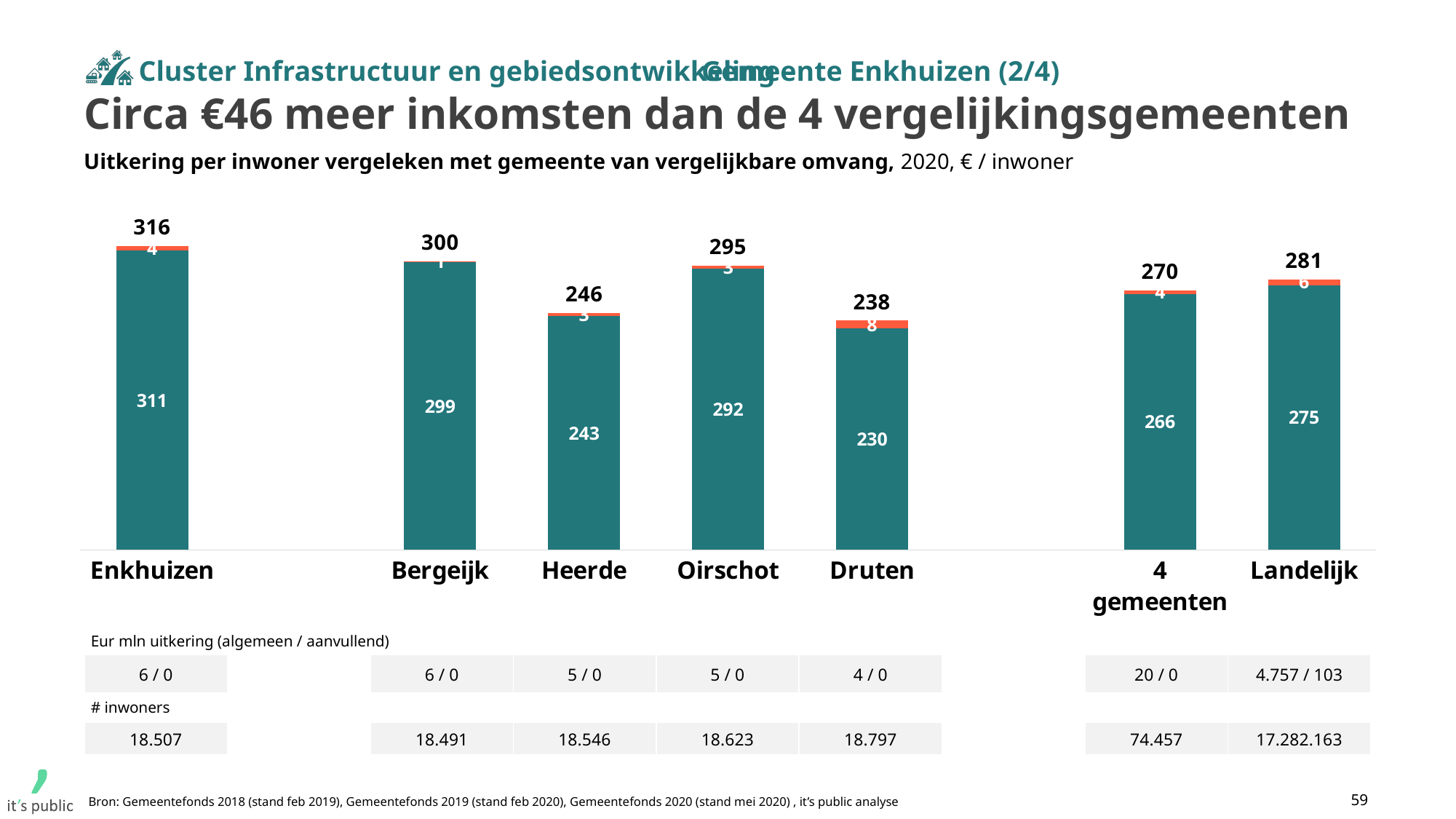
What is the total value shown above the bar for Landelijk? 281 How many categories (bars) are shown in the chart? 7 What is the total value shown above the bar for Enkhuizen? 316 What is the value of the teal segment for 4 gemeenten? 266 Which category has the lowest total value? Druten Which has a higher total value, Bergeijk or Oirschot? Bergeijk What kind of chart is shown on the slide? Stacked bar chart What is the value of the small orange segment on top of the Druten bar? 8 Which category has the highest total value? Enkhuizen What is the difference between the total for Heerde and the total for Druten? 8 What is the difference between the total for Enkhuizen and the total for 4 gemeenten? 46 What is the value of the large teal segment for Druten? 230